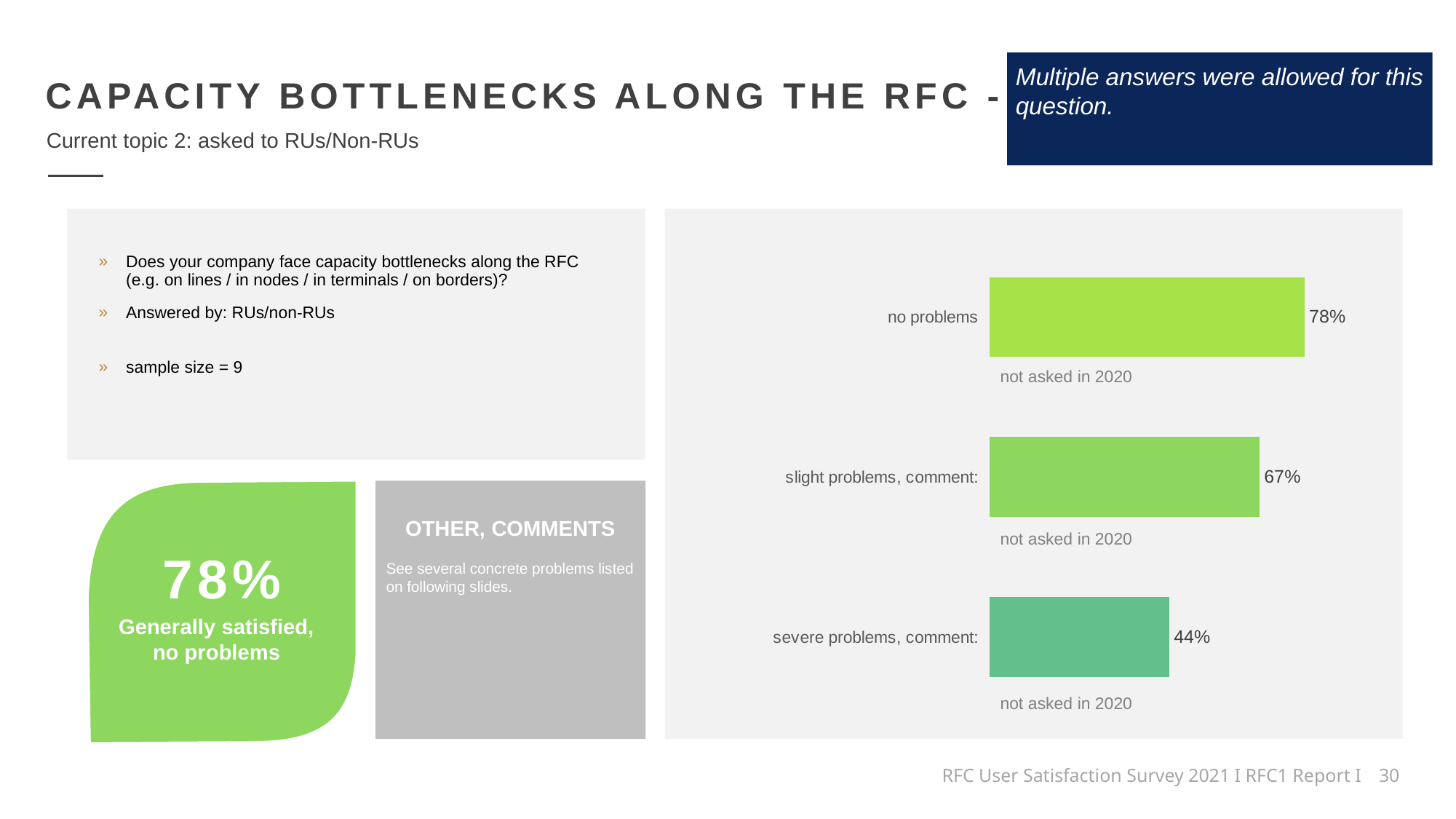
What kind of chart is shown on the slide? bar chart What text appears beneath each bar in the chart regarding the 2020 survey? not asked in 2020 Which category has the lowest value in the chart? severe problems, comment: What is the value shown for 'slight problems, comment:'? 67% What is the sample size stated for this question? 9 What percentage of respondents reported no problems with capacity bottlenecks along the RFC? 78% What is the difference between the values for 'no problems' and 'severe problems, comment:'? 34% What is the value shown for 'severe problems, comment:'? 44% Which category has the highest value in the chart? no problems Which is larger, the value for 'slight problems, comment:' or the value for 'severe problems, comment:'? slight problems, comment: What is the difference between the values for 'slight problems, comment:' and 'severe problems, comment:'? 23% How many categories are shown in the chart? 3